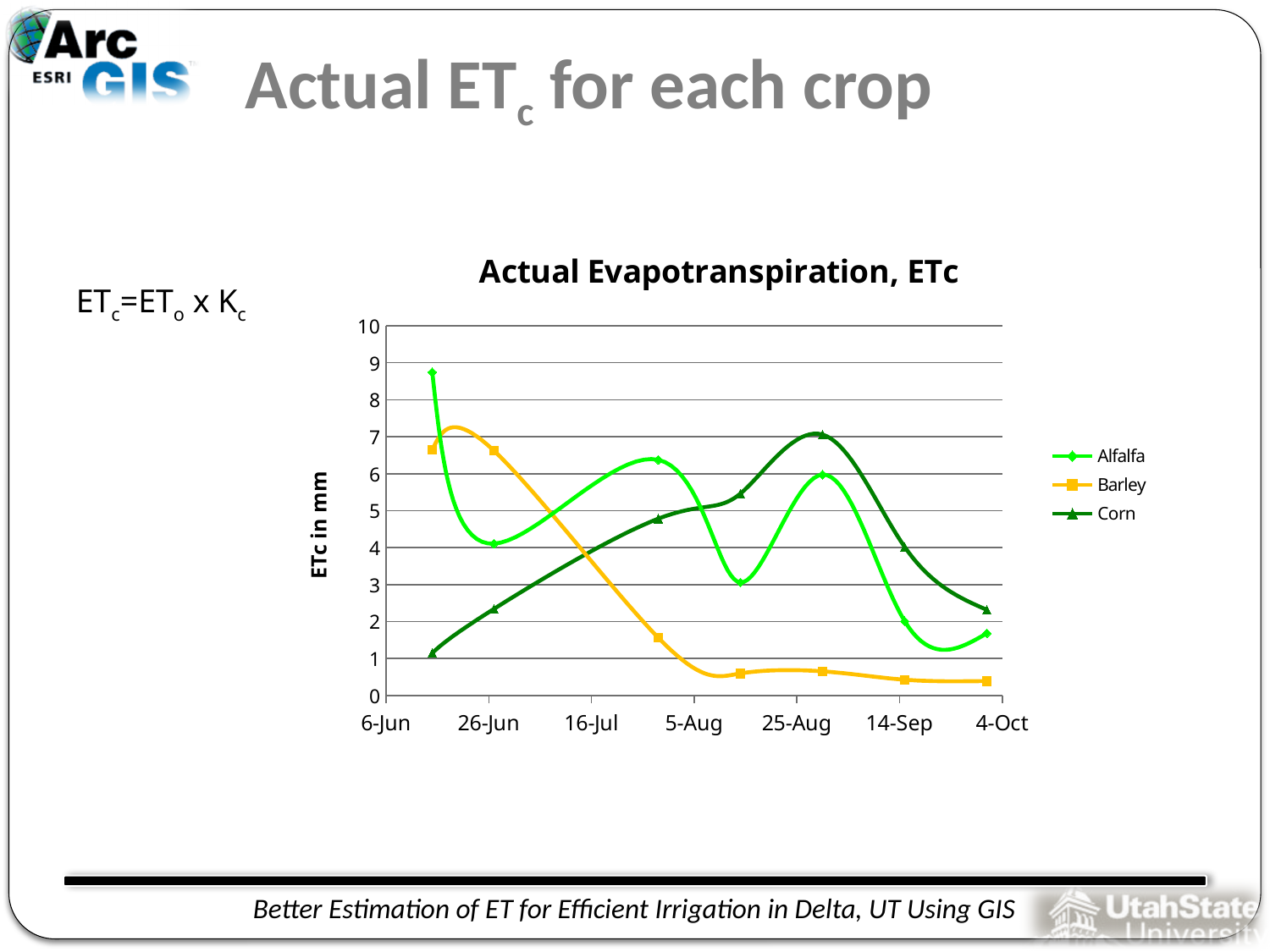
Which series reaches the highest value on the chart? Alfalfa What is the title of the chart? Actual Evapotranspiration, ETc Which series has the lowest value at the end of the period (near 4-Oct)? Barley How many date labels are shown along the x axis? 7 Does the Barley series generally rise or fall from June to October? fall Is the first plotted value for Alfalfa greater or less than 8? greater What is the label on the vertical axis of the chart? ETc in mm Is the peak value for Corn greater or less than 6? greater At the last plotted point, which series is higher, Corn or Alfalfa? Corn Is the last plotted value for Barley greater or less than 1? less What kind of chart is shown on the slide? line chart How many series does the legend list? 3